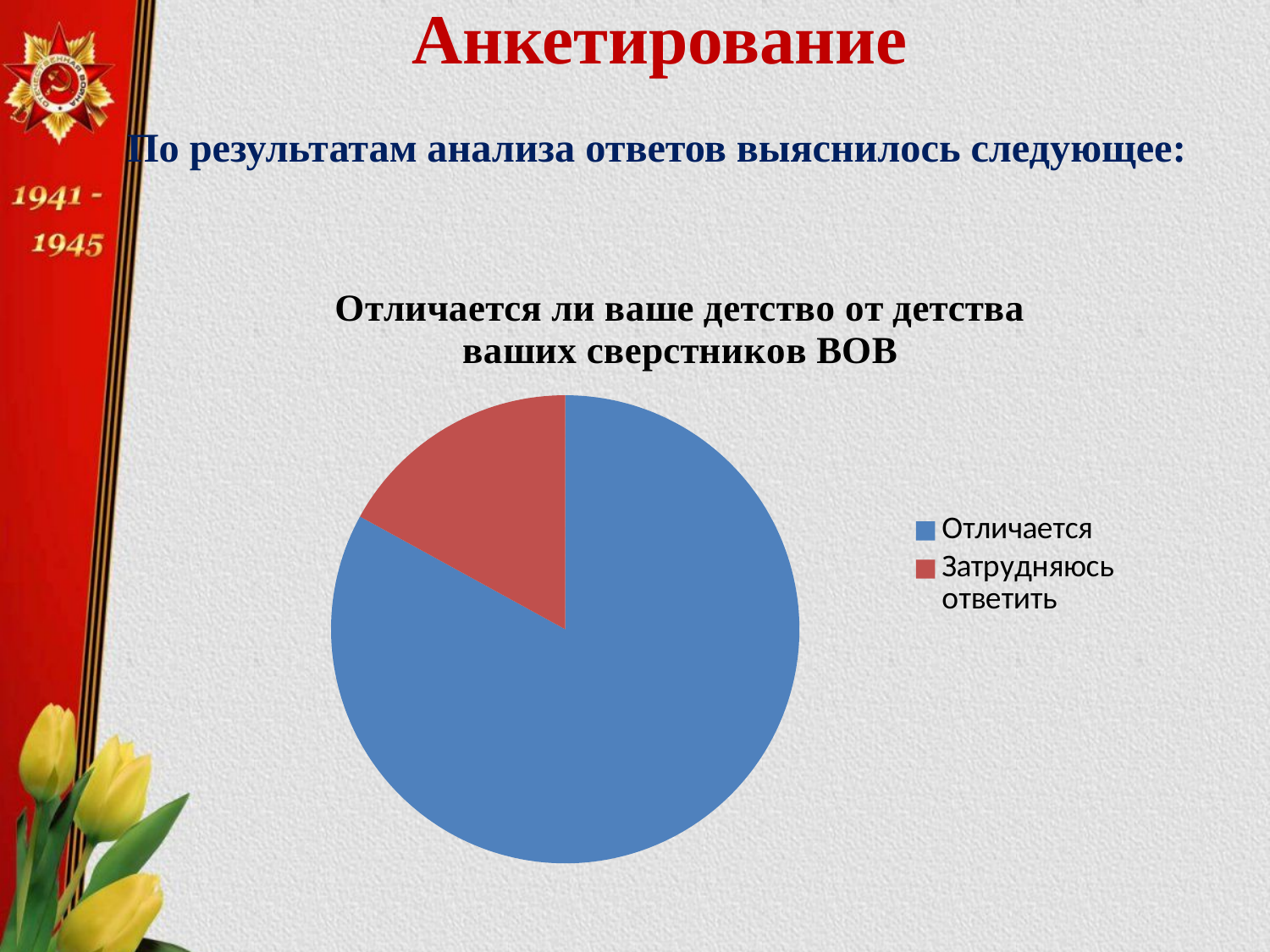
What kind of chart is shown on the slide? pie chart Which slice is larger: Отличается or Затрудняюсь ответить? Отличается What is the title of the pie chart? Отличается ли ваше детство от детства ваших сверстников ВОВ Which category has the smallest slice in the pie chart? Затрудняюсь ответить How many slices does the pie chart have? 2 What colour is the slice for Затрудняюсь ответить? red Which category has the largest slice in the pie chart? Отличается How many entries does the legend of the pie chart list? 2